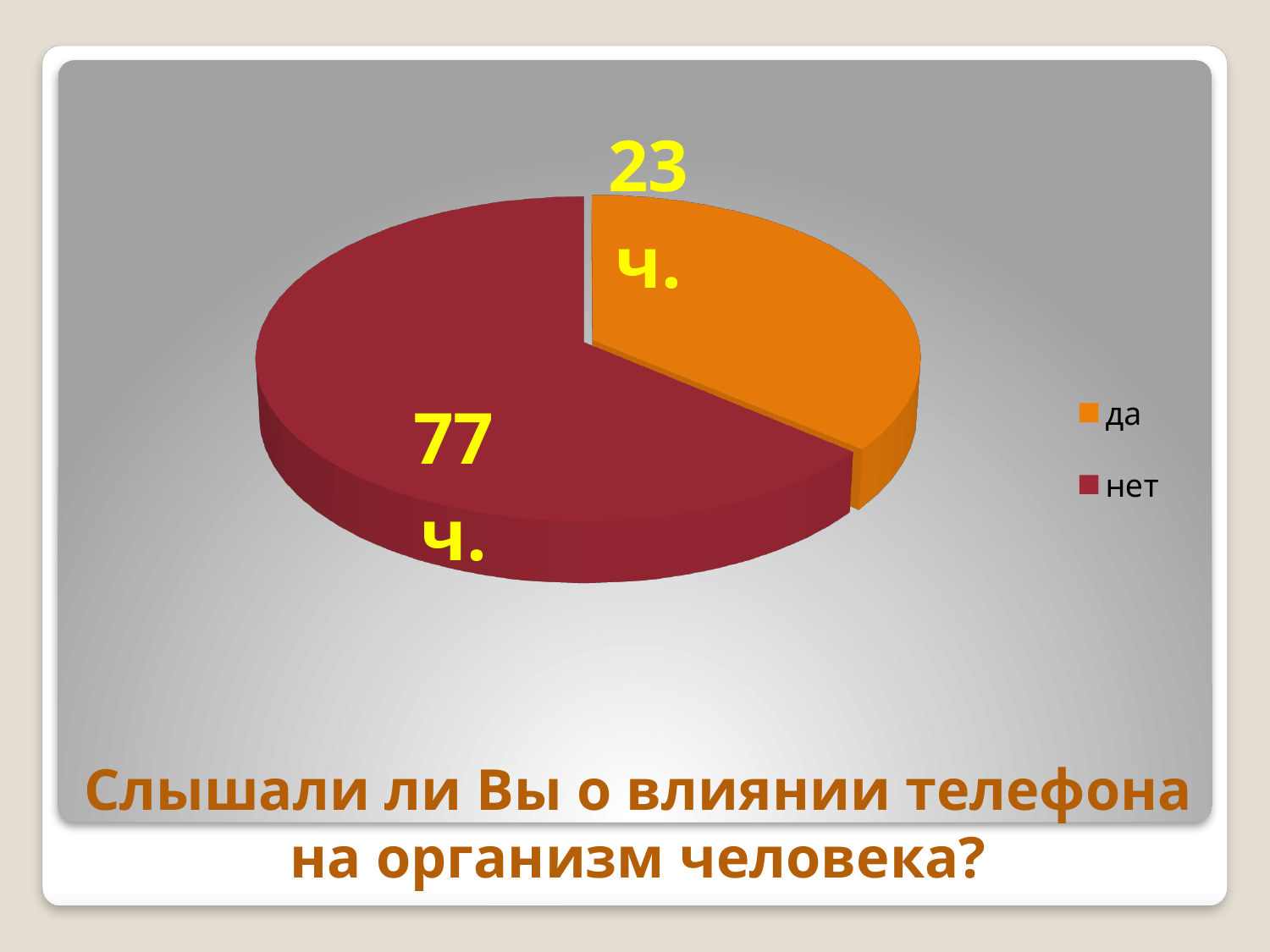
What value is shown for the "да" slice? 23 ч. Which is larger, the value for "да" or the value for "нет"? нет Which category has the largest slice of the pie? нет What is the total of the two slices shown in the pie chart? 100 ч. What kind of chart is shown on the slide? pie chart What value is shown for the "нет" slice? 77 ч. How many entries does the legend list? 2 What is the difference between the "нет" value and the "да" value? 54 ч. What colour is the "да" slice in the pie chart? orange Which category has the smallest slice of the pie? да How many categories does the pie chart have? 2